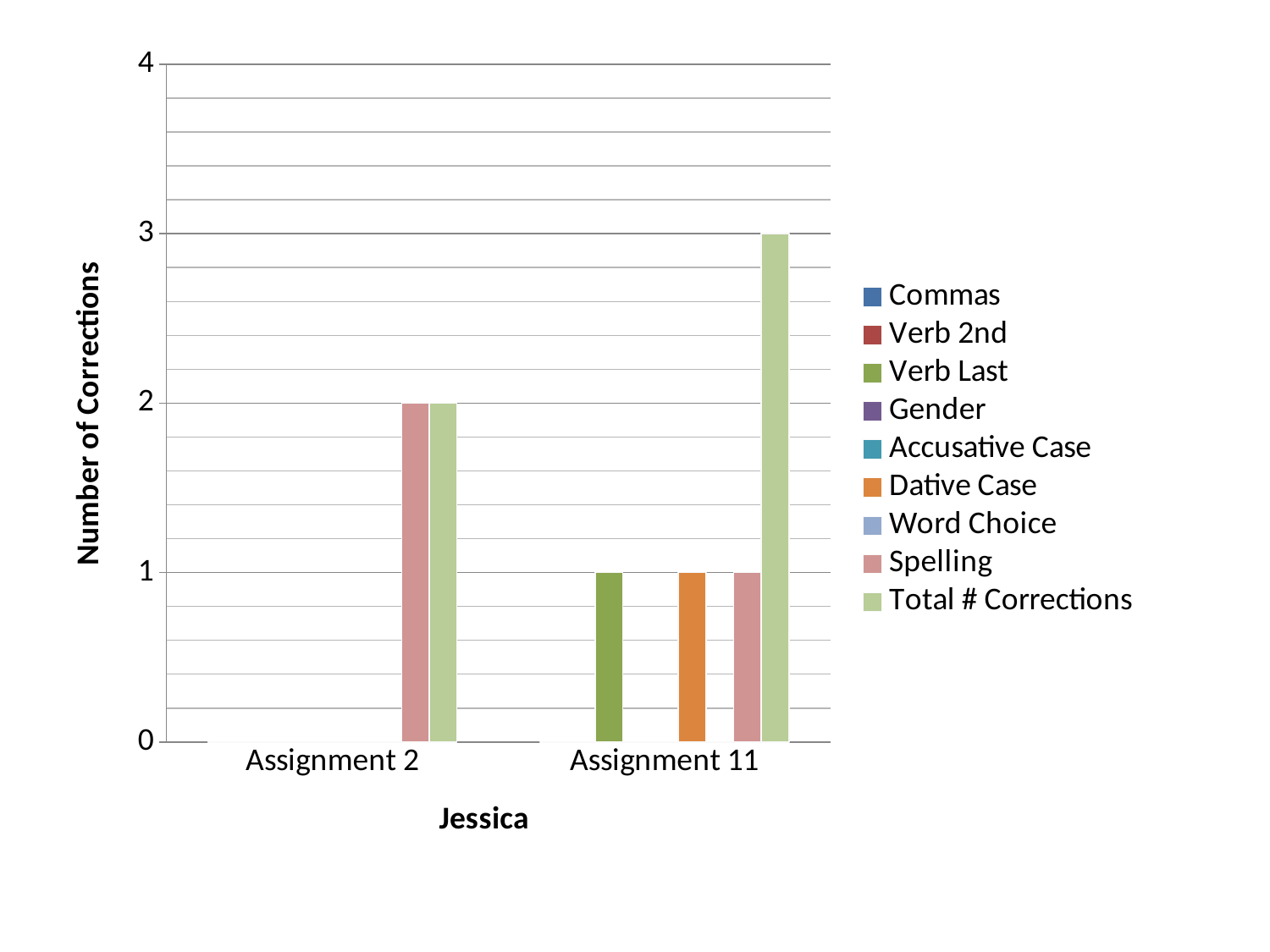
What is the value of Total # Corrections for Assignment 11? 3 What is the value of Dative Case for Assignment 11? 1 What is the label of the y axis? Number of Corrections What is the value of Total # Corrections for Assignment 2? 2 What kind of chart is shown on the slide? bar chart What is the value of Verb Last for Assignment 11? 1 Which assignment has the higher Total # Corrections? Assignment 11 What is the difference in Total # Corrections between Assignment 11 and Assignment 2? 1 How many categories are shown on the x axis? 2 Is the Spelling value for Assignment 2 larger or smaller than the Spelling value for Assignment 11? larger How many series does the legend list? 9 What is the value of Spelling for Assignment 2? 2